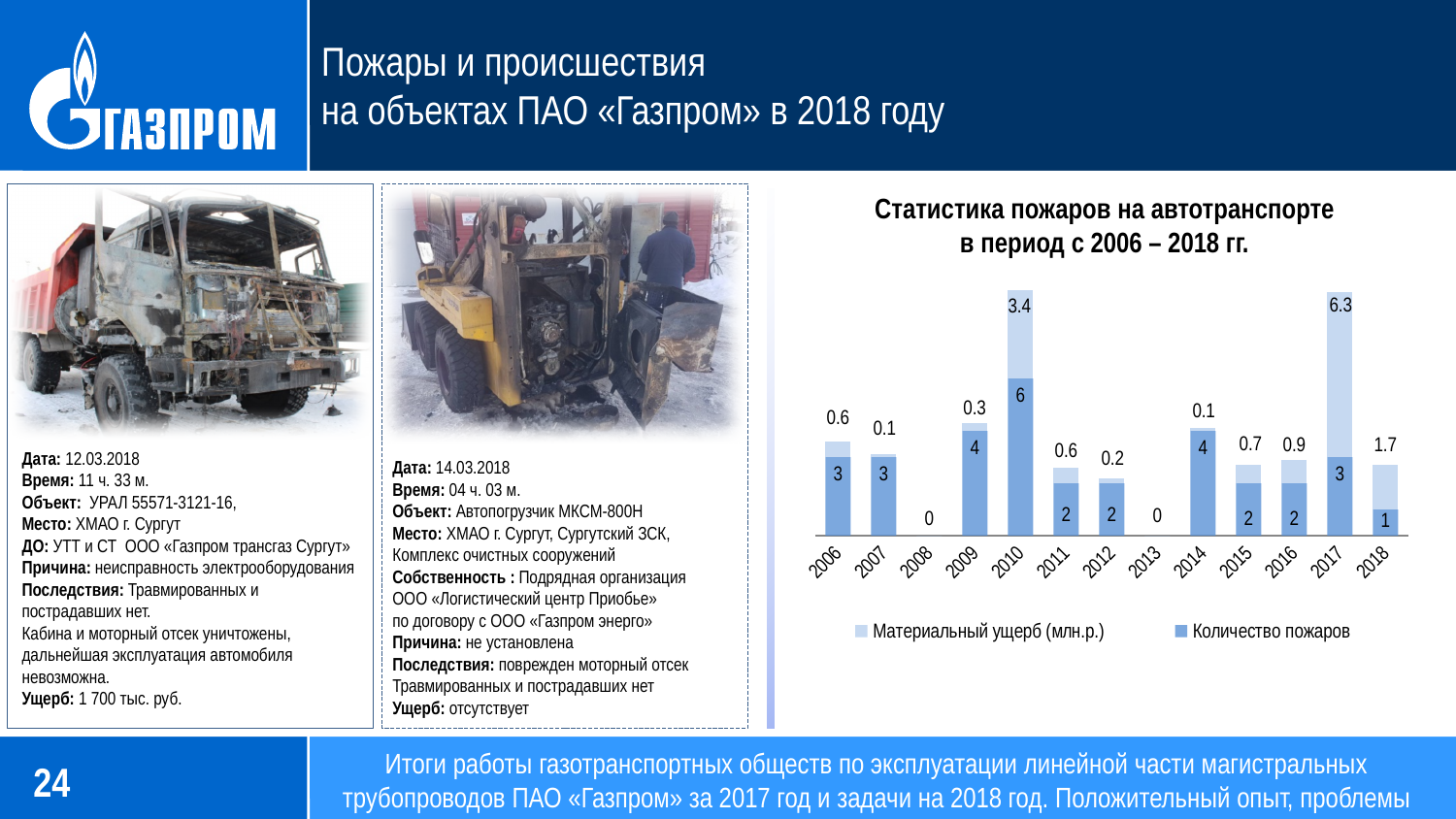
How many years are shown on the x axis of the chart? 13 What is the value of Количество пожаров for 2010? 6 What is the title of the chart? Статистика пожаров на автотранспорте в период с 2006 – 2018 гг. What is the difference in Материальный ущерб (млн.р.) between 2017 and 2010? 2.9 What is the total of the stacked bar for 2016? 2.9 Which year has the highest Материальный ущерб (млн.р.)? 2017 What is the value of Материальный ущерб (млн.р.) for 2017? 6.3 Which is larger, Количество пожаров in 2009 or in 2018? 2009 Which year has the highest Количество пожаров? 2010 What is the value of Материальный ущерб (млн.р.) for 2018? 1.7 How many series does the chart legend list? 2 What type of chart is shown on the slide? Stacked bar chart